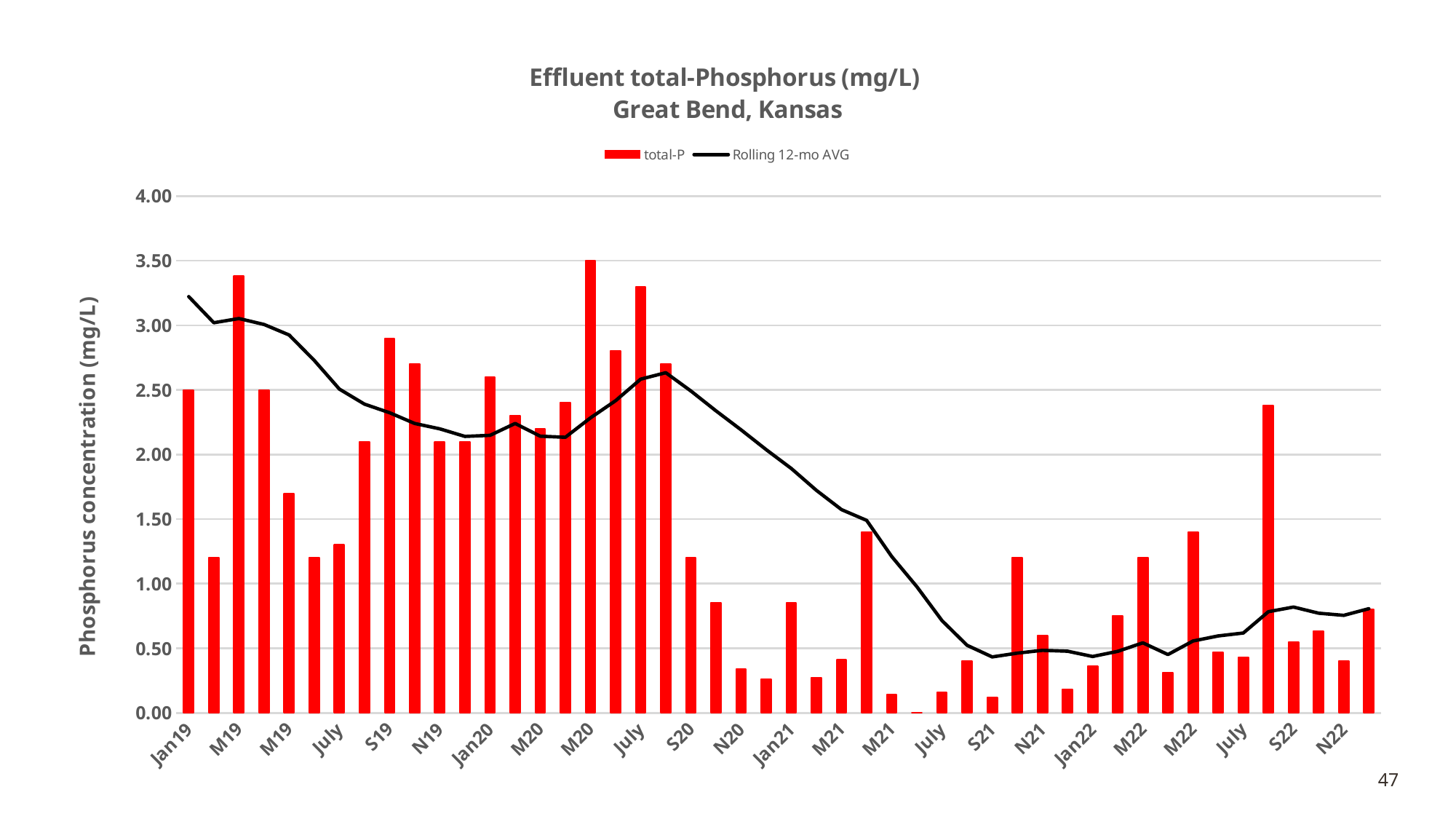
Does the Rolling 12-mo AVG line generally rise or fall from Jan19 to N22? fall What kind of chart is shown on the slide? A bar chart with a line overlay Is the total-P value for Jan19 greater or less than 2.00? greater What are the two series named in the legend? total-P and Rolling 12-mo AVG Is the Rolling 12-mo AVG value at Jan19 greater or less than 3.00? greater Which has the larger total-P value, Jan19 or Jan22? Jan19 What is the title of the chart? Effluent total-Phosphorus (mg/L) Great Bend, Kansas Is the total-P value for Jan21 greater or less than 0.50? greater How many series does the legend list? 2